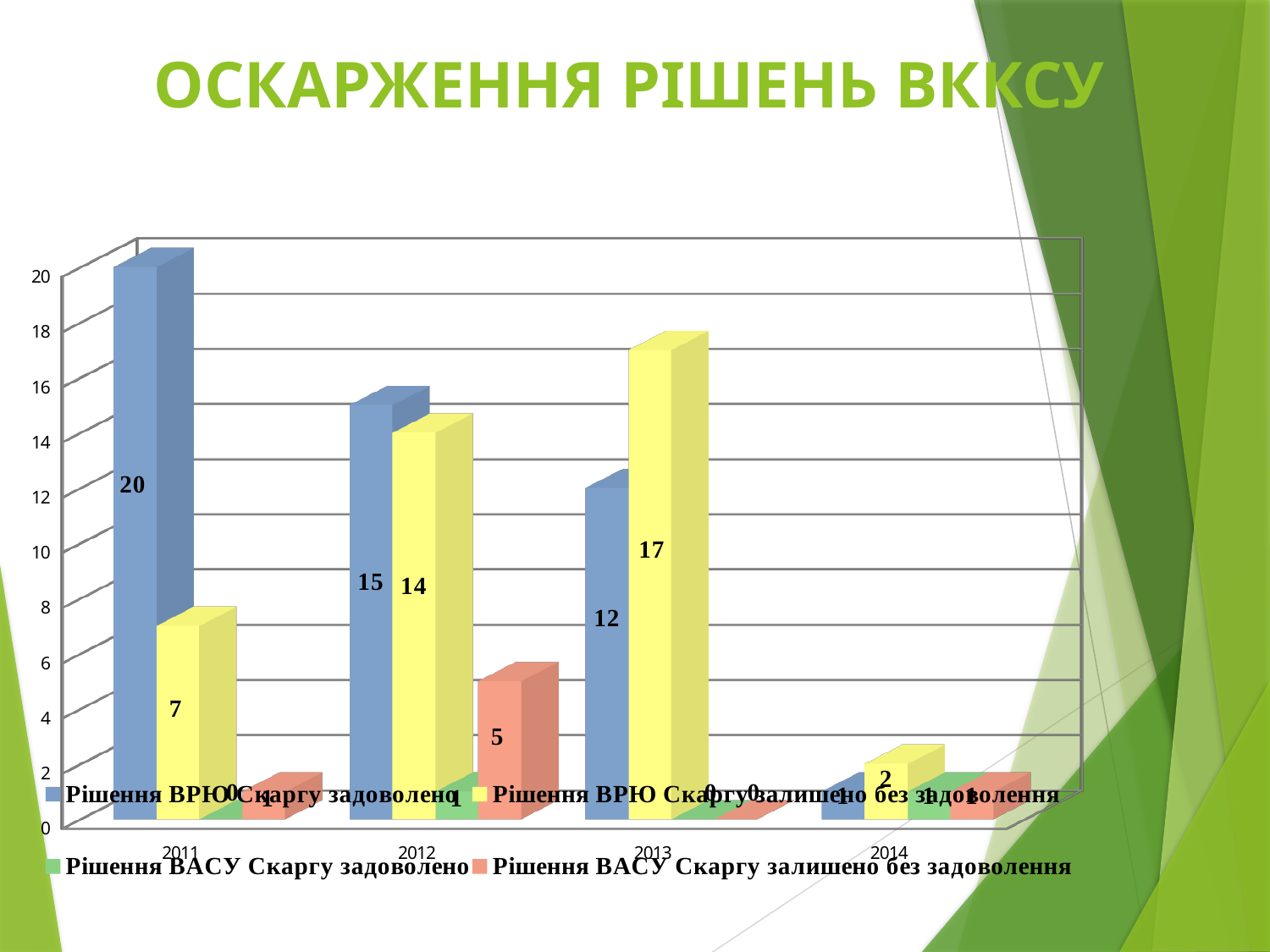
What is the value for "Рішення ВРЮ Скаргу залишено без задоволення" in 2012? 14 What is the value for "Рішення ВАСУ Скаргу залишено без задоволення" in 2012? 5 In which year is the value for "Рішення ВРЮ Скаргу задоволено" highest? 2011 How many series does the legend list? 4 What is the value for "Рішення ВРЮ Скаргу залишено без задоволення" in 2013? 17 What is the value for "Рішення ВРЮ Скаргу задоволено" in 2011? 20 How many years are shown on the x axis? 4 What is the difference between "Рішення ВРЮ Скаргу задоволено" and "Рішення ВРЮ Скаргу залишено без задоволення" in 2011? 13 In 2013, which is larger: "Рішення ВРЮ Скаргу задоволено" or "Рішення ВРЮ Скаргу залишено без задоволення"? Рішення ВРЮ Скаргу залишено без задоволення Does the value for "Рішення ВРЮ Скаргу задоволено" rise or fall from 2011 to 2014? Fall What kind of chart is shown on the slide? Bar chart What is the title of the slide? ОСКАРЖЕННЯ РІШЕНЬ ВККСУ